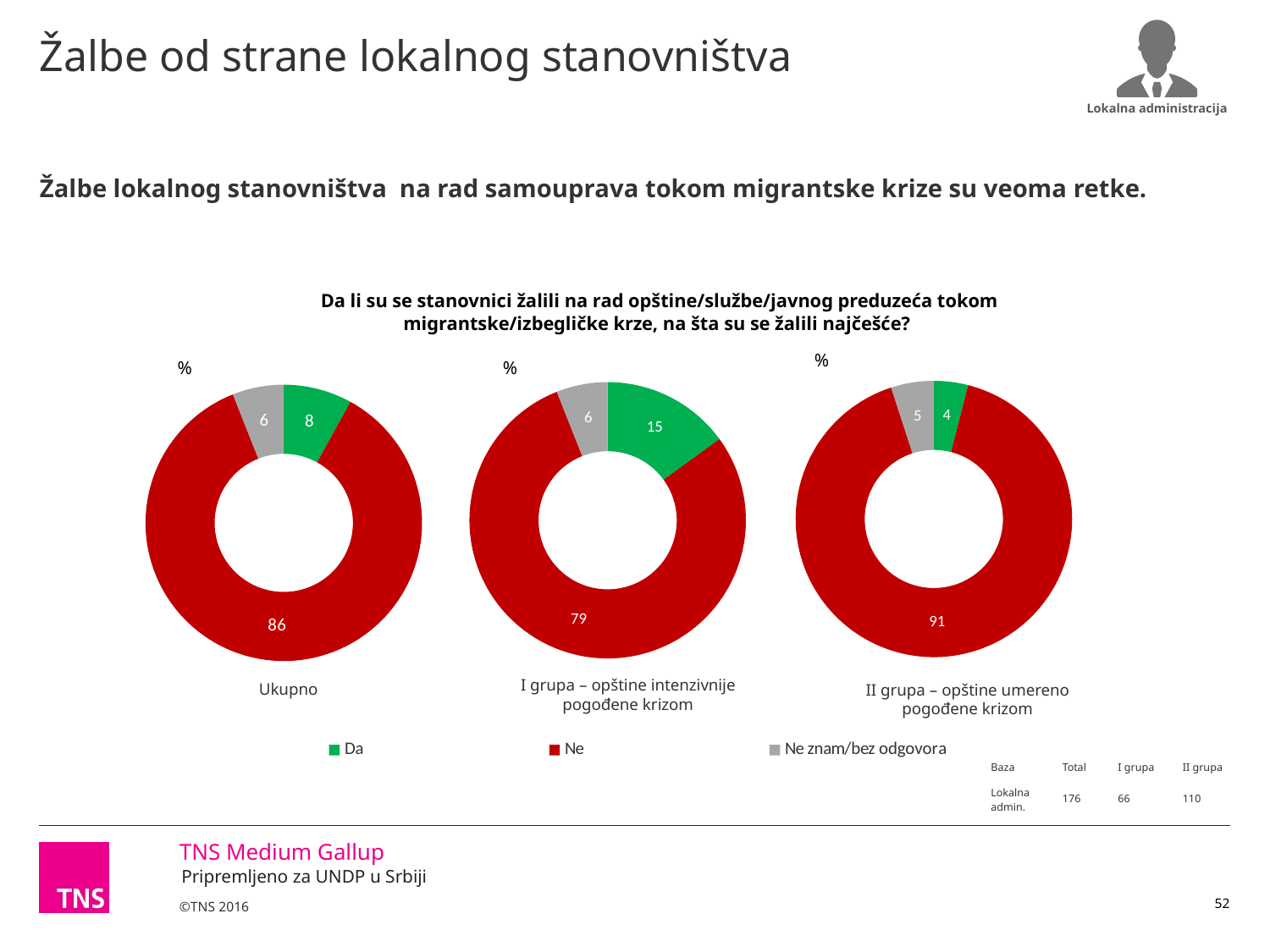
What kind of chart is used to show the 'Ukupno' data? Donut (pie) chart In the 'I grupa – opštine intenzivnije pogođene krizom' donut chart, what is the difference between the values for 'Ne' and 'Da'? 64 In the 'Ukupno' donut chart, which category has the highest value? Ne In the 'II grupa – opštine umereno pogođene krizom' donut chart, which category has the lowest value? Da In the 'Ukupno' donut chart, is the value for 'Da' larger or smaller than the value for 'Ne znam/bez odgovora'? larger In the 'Ukupno' donut chart, what is the value for 'Ne'? 86 Which colour represents 'Ne' in the charts? Red Which chart has the larger value for 'Da': 'I grupa – opštine intenzivnije pogođene krizom' or 'II grupa – opštine umereno pogođene krizom'? I grupa – opštine intenzivnije pogođene krizom In the 'II grupa – opštine umereno pogođene krizom' donut chart, what is the value for 'Ne znam/bez odgovora'? 5 How many slices does the 'Ukupno' donut chart have? 3 In the 'I grupa – opštine intenzivnije pogođene krizom' donut chart, what is the value for 'Da'? 15 How many entries does the legend list? 3